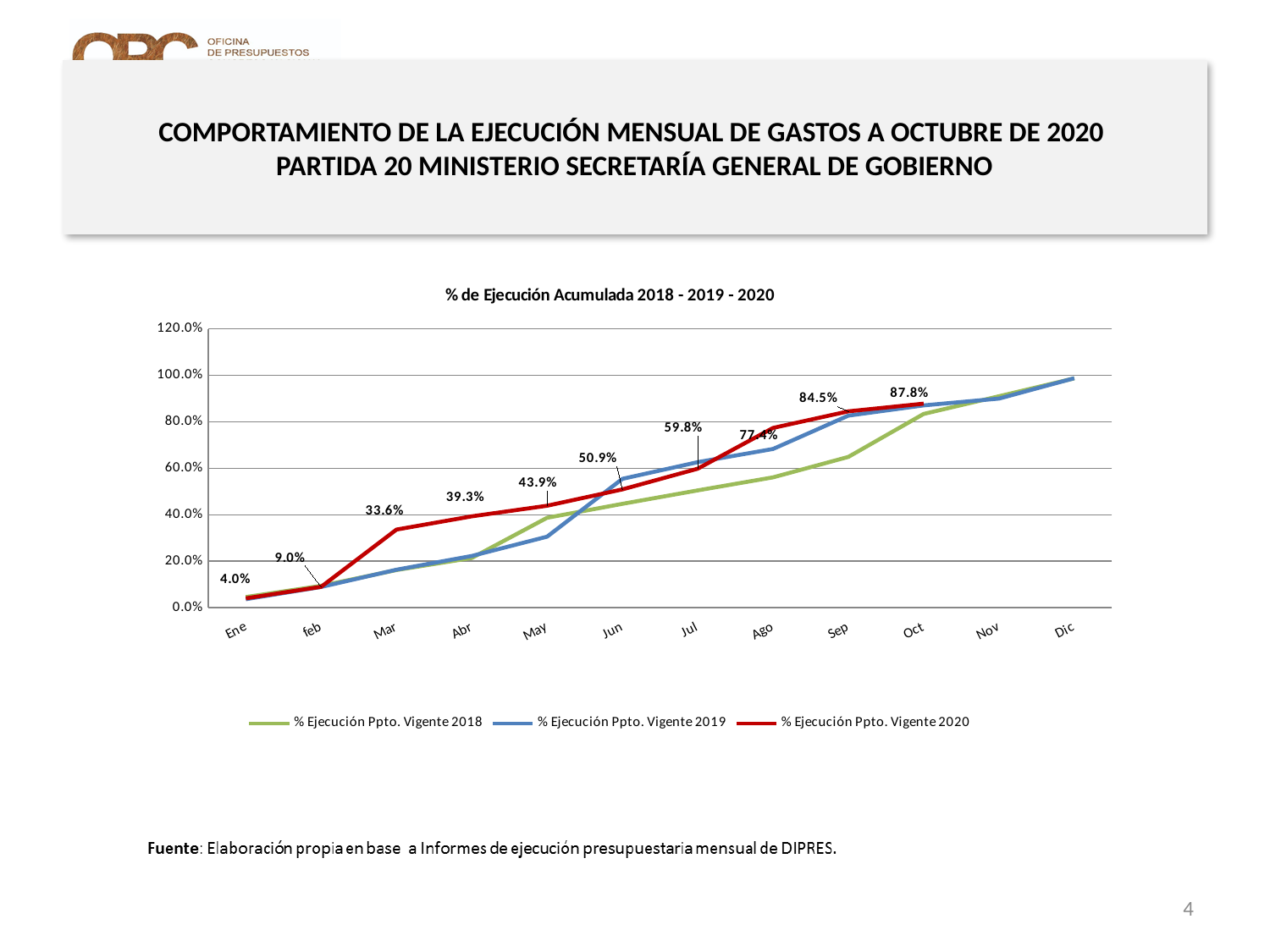
What is the value of % Ejecución Ppto. Vigente 2020 for Jun? 50.9% What kind of chart is shown on the slide? Line chart By how many percentage points does the 2020 series increase from feb to Mar? 24.6 How many months are shown on the x axis? 12 In which month does the % Ejecución Ppto. Vigente 2020 series reach its highest labelled value? Oct What is the value of % Ejecución Ppto. Vigente 2020 for Mar? 33.6% What is the difference between the 2020 values for Sep and Oct? 3.3 In which month is the % Ejecución Ppto. Vigente 2020 series lowest? Ene How many series does the legend list? 3 What is the value of % Ejecución Ppto. Vigente 2020 for Ene? 4.0% What is the value of % Ejecución Ppto. Vigente 2020 for Oct? 87.8% Is the value for % Ejecución Ppto. Vigente 2018 in Sep greater or less than 80.0%? less